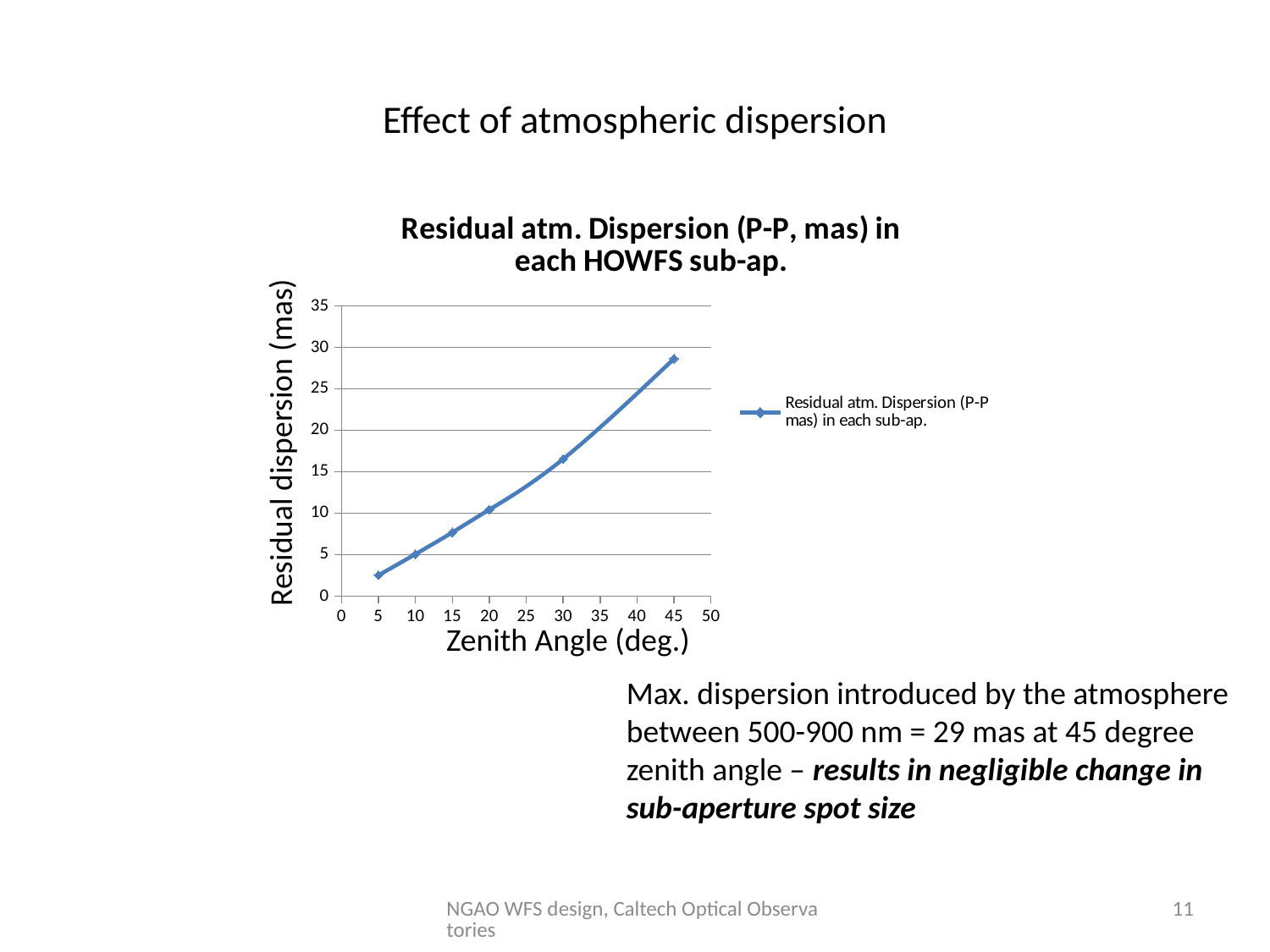
Is the residual dispersion at a zenith angle of 45 degrees greater or less than 25? greater What kind of chart is shown on the slide? line chart Is the residual dispersion at a zenith angle of 15 degrees greater or less than 10? less What is the label of the x axis? Zenith Angle (deg.) At which zenith angle is the residual dispersion highest? 45 How many data points are plotted on the line? 6 Does the residual dispersion rise or fall as the zenith angle increases? rise At which zenith angle is the residual dispersion lowest? 5 How many series does the chart legend list? 1 Is the residual dispersion at a zenith angle of 5 degrees greater or less than 5? less Which has the larger residual dispersion, a zenith angle of 30 degrees or 45 degrees? 45 degrees What is the title of the chart? Residual atm. Dispersion (P-P, mas) in each HOWFS sub-ap.